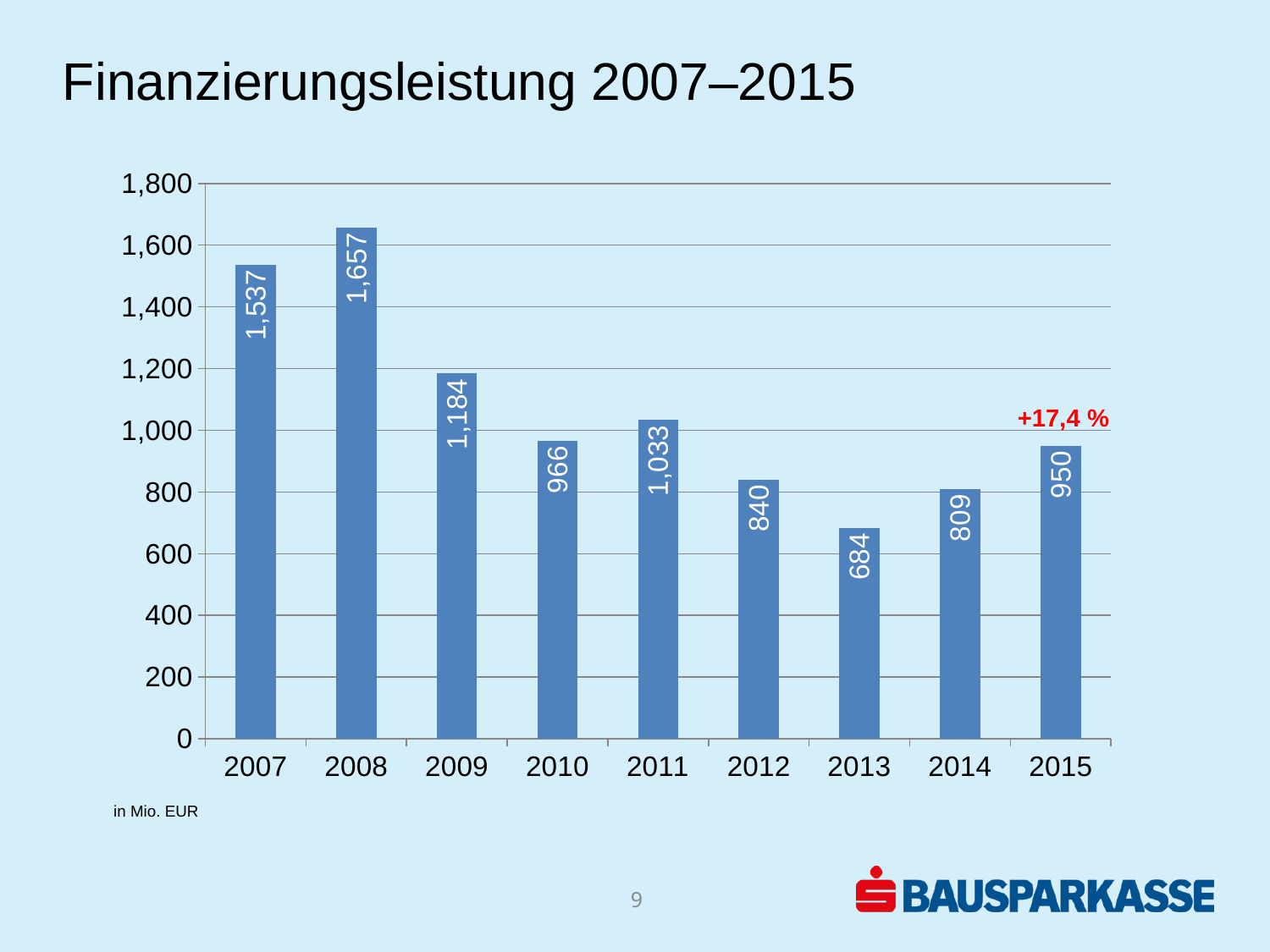
What is the value for 2013? 684 What is the difference between the values for 2008 and 2007? 120 Is the value for 2009 greater or less than 1,000? greater What kind of chart is shown on the slide? bar chart Which year has the lowest value? 2013 Which is larger, the value for 2010 or the value for 2011? 2011 What percentage change is annotated above the 2015 bar? +17,4 % How many years are shown on the x axis? 9 Which year has the highest value? 2008 What is the difference between the values for 2015 and 2014? 141 What is the value for 2008? 1,657 What is the value for 2015? 950